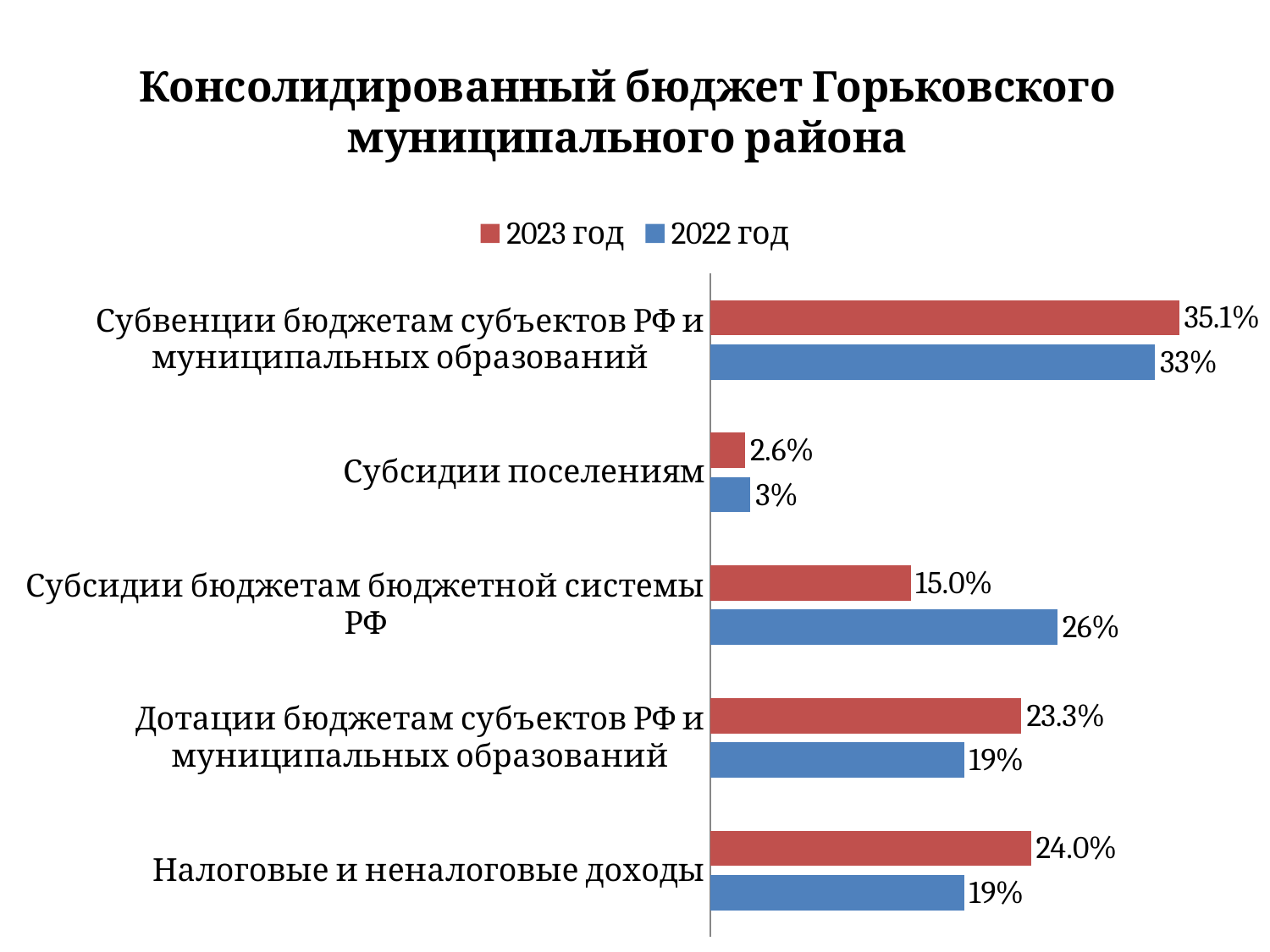
What is the 2022 год value for Субсидии бюджетам бюджетной системы РФ? 26% What kind of chart is shown on the slide? Bar chart Which category has the lowest 2022 год value? Субсидии поселениям What is the 2023 год value for Налоговые и неналоговые доходы? 24.0% What is the 2023 год value for Субвенции бюджетам субъектов РФ и муниципальных образований? 35.1% What is the 2022 год value for Субсидии поселениям? 3% What is the difference between the 2022 год and 2023 год values for Субсидии бюджетам бюджетной системы РФ? 11% For Дотации бюджетам субъектов РФ и муниципальных образований, which year has the larger value, 2023 год or 2022 год? 2023 год Which category has the highest 2023 год value? Субвенции бюджетам субъектов РФ и муниципальных образований Which colour represents 2022 год in the chart? Blue How many series does the legend list? 2 How many categories are shown on the chart? 5